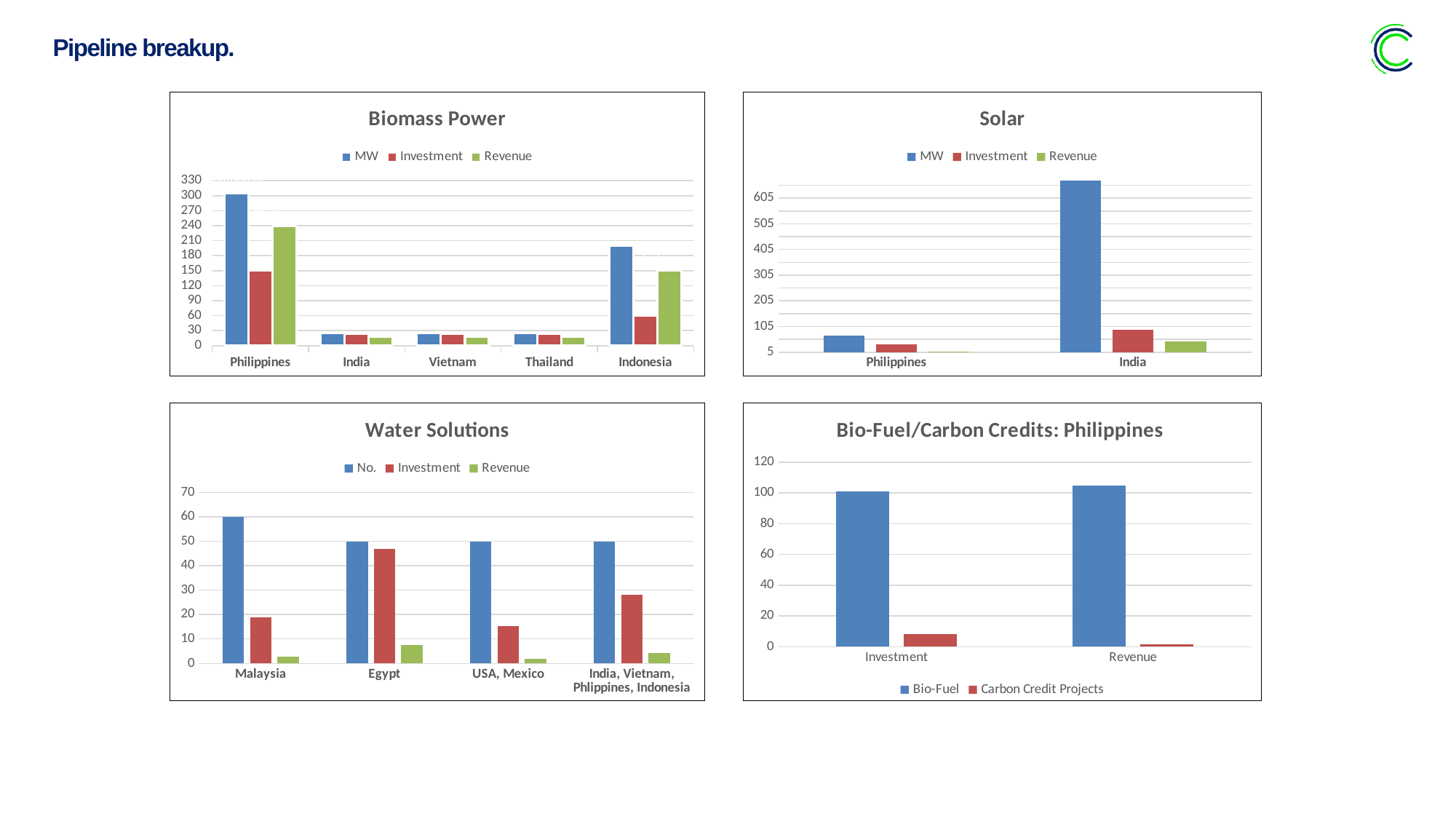
In the Solar chart, which country has the higher MW value, Philippines or India? India In the Biomass Power chart, which country has the highest MW value? Philippines In the Biomass Power chart, how many series does the legend list? 3 How many charts are on the slide? 4 In the Bio-Fuel/Carbon Credits: Philippines chart, what are the two series listed in the legend? Bio-Fuel and Carbon Credit Projects In the Solar chart, is the MW value for India greater or less than 605? greater What kind of chart is the Biomass Power chart? bar chart In the Water Solutions chart, which category has the highest Investment value? Egypt In the Water Solutions chart, what is the No. value for Egypt? 50 In the Biomass Power chart, how many countries are shown on the x axis? 5 In the Water Solutions chart, what is the No. value for Malaysia? 60 In the Biomass Power chart, is the MW value for Indonesia greater or less than 180? greater